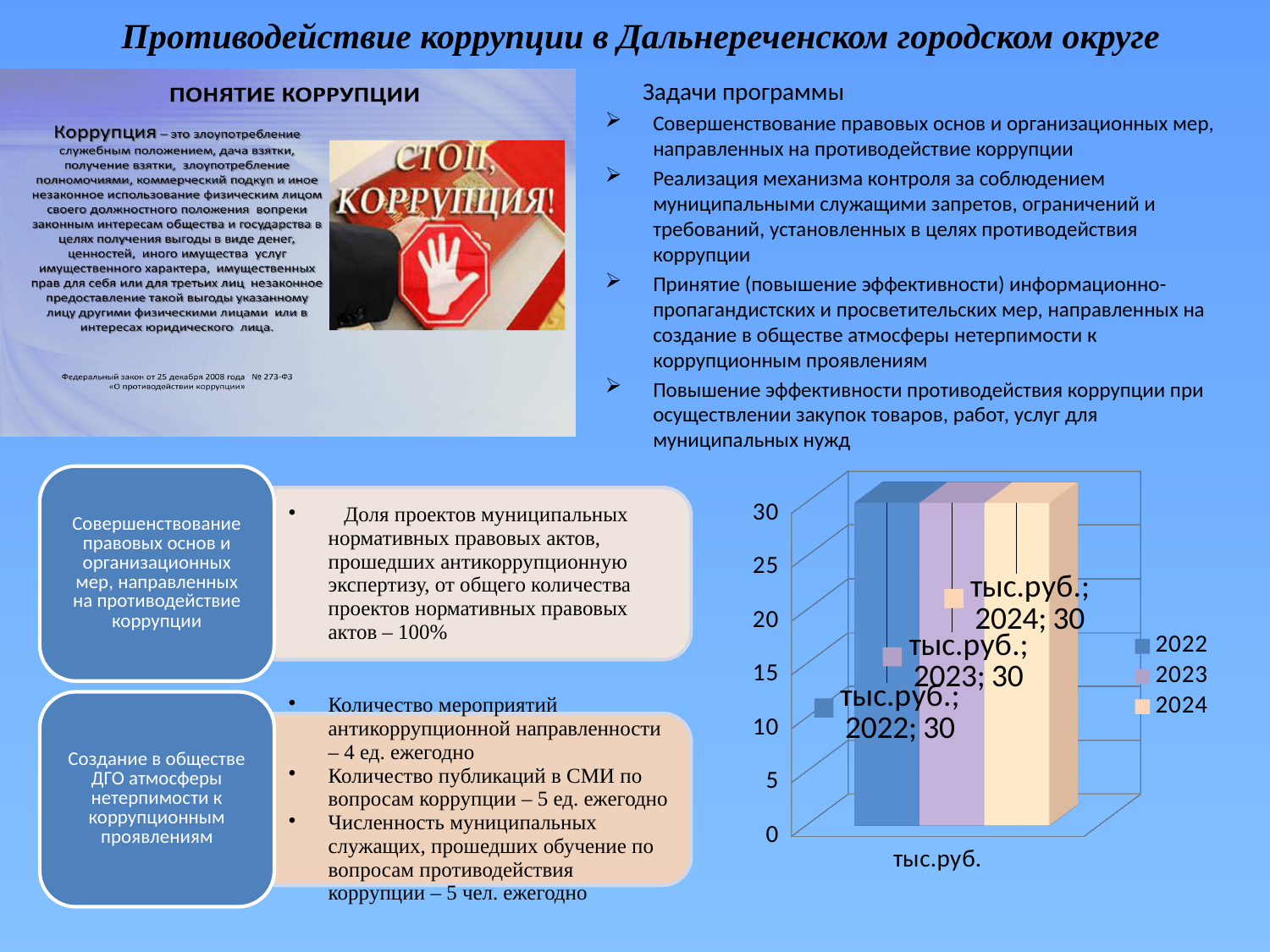
What kind of chart is shown on the slide? bar chart How many series does the chart legend list? 3 What is the value for the 2024 series in the chart? 30 How many categories are shown on the x axis of the chart? 1 What is the difference between the 2024 value and the 2022 value in the chart? 0 What is the value for the 2022 series in the chart? 30 What is the highest value shown on the chart's vertical axis? 30 What is the value for the 2023 series in the chart? 30 Which years are listed in the chart legend? 2022, 2023, 2024 What is the category label shown on the x axis of the chart? тыс.руб. Do the values change from 2022 to 2024 in the chart? No, they stay at 30 Is the value for 2023 greater or less than 25? greater